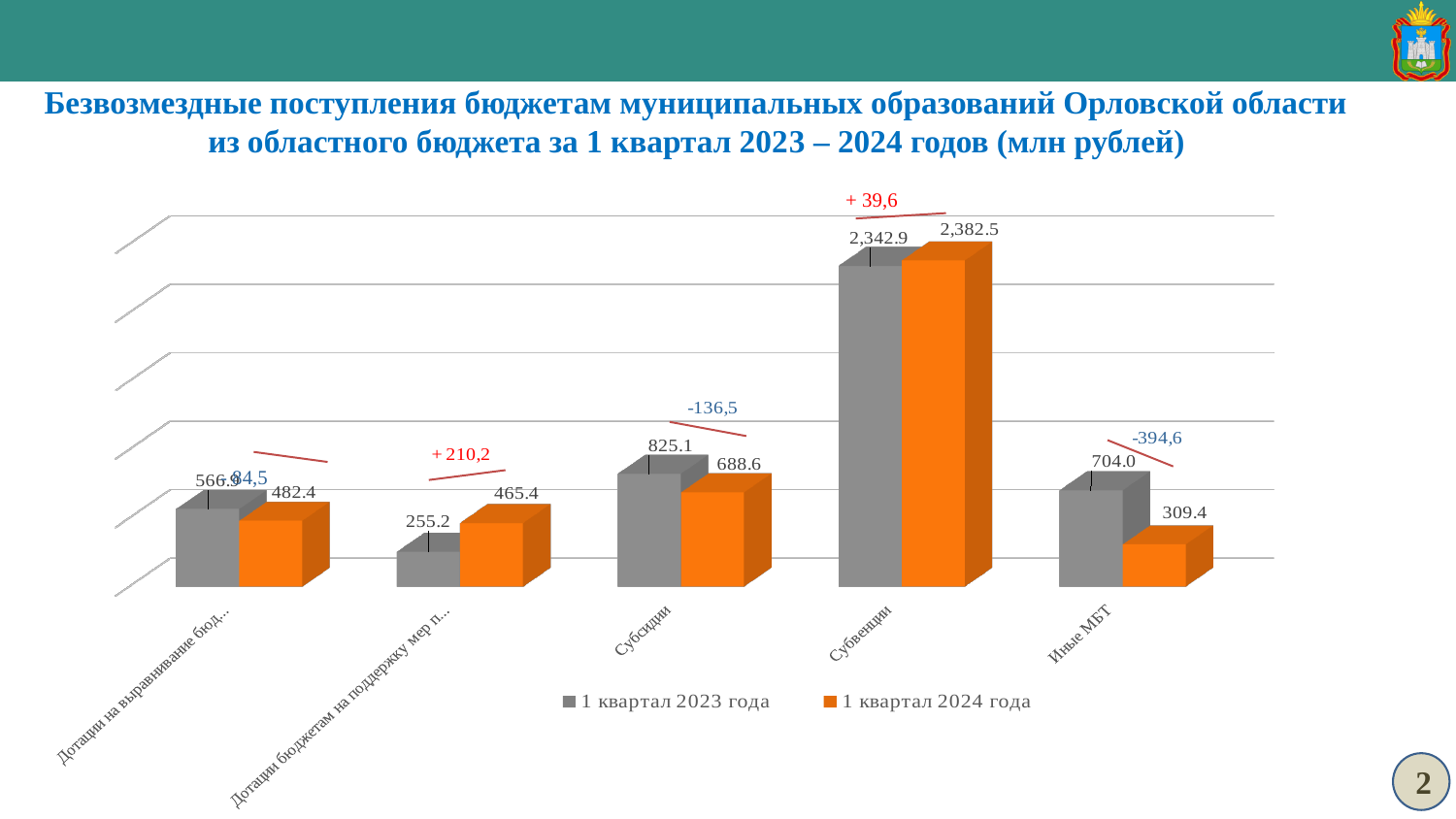
What is the value for Субсидии in 1 квартал 2023 года? 825.1 What is the value for Субвенции in 1 квартал 2023 года? 2,342.9 Which category has the lowest value in 1 квартал 2024 года? Иные МБТ What is the value for Иные МБТ in 1 квартал 2024 года? 309.4 How many categories are shown on the x axis? 5 How many series does the legend list? 2 What is the difference between the 1 квартал 2023 года and 1 квартал 2024 года values for Иные МБТ? 394.6 What kind of chart is shown on the slide? bar chart Which category has the highest value in 1 квартал 2024 года? Субвенции What is the difference between the 1 квартал 2023 года and 1 квартал 2024 года values for Субсидии? 136.5 For Субсидии, which is larger: the value for 1 квартал 2023 года or 1 квартал 2024 года? 1 квартал 2023 года What is the value for Субвенции in 1 квартал 2024 года? 2,382.5